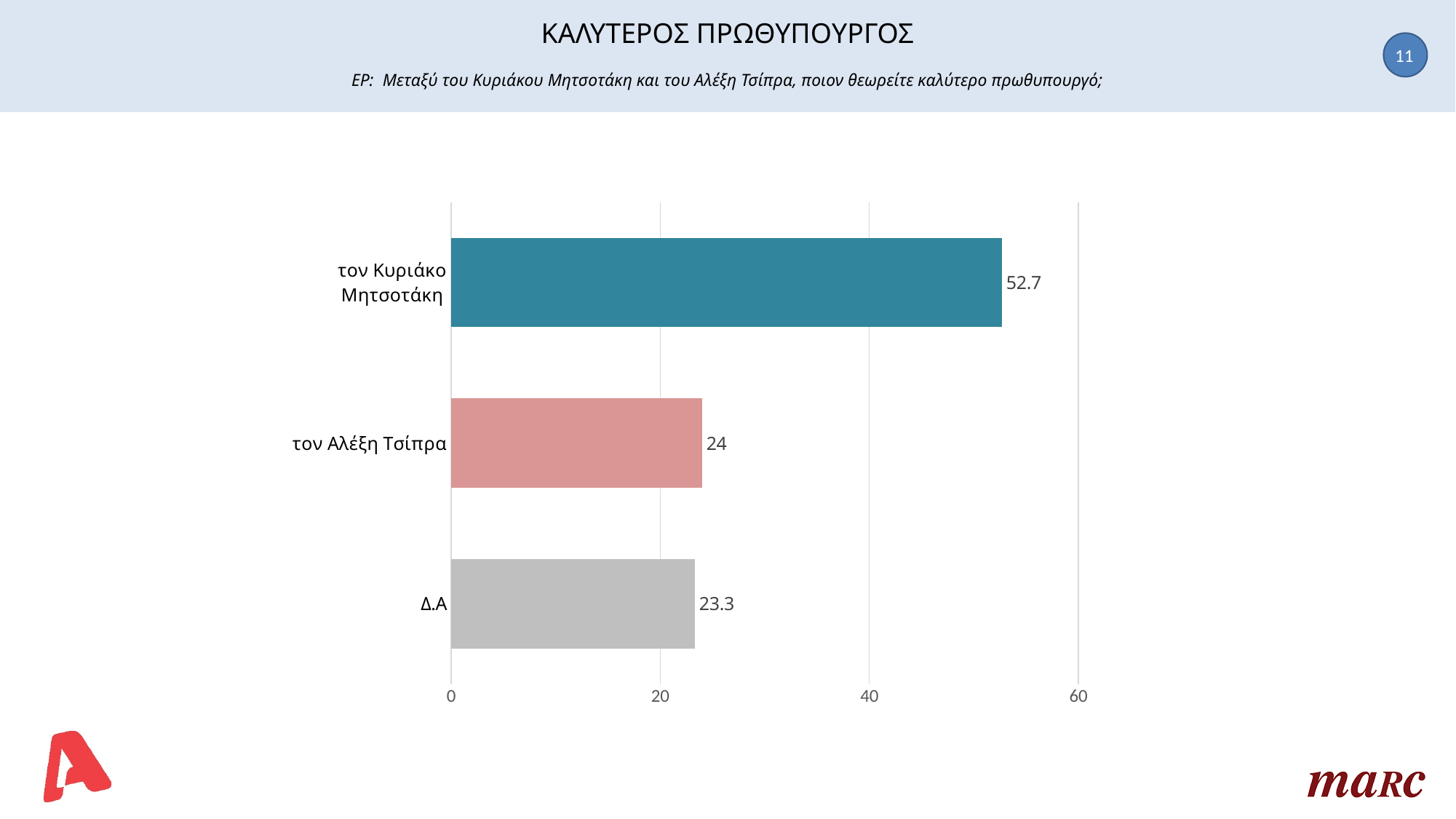
What is the difference between the values for τον Αλέξη Τσίπρα and Δ.Α? 0.7 Is the value for τον Κυριάκο Μητσοτάκη greater or less than 40? greater What is the value for τον Κυριάκο Μητσοτάκη? 52.7 Which category has the lowest value? Δ.Α What is the value for Δ.Α? 23.3 What is the value for τον Αλέξη Τσίπρα? 24 What is the title of the slide? ΚΑΛΥΤΕΡΟΣ ΠΡΩΘΥΠΟΥΡΓΟΣ How many categories are shown in the chart? 3 Which category has the highest value? τον Κυριάκο Μητσοτάκη What kind of chart is shown on the slide? bar chart What is the difference between the values for τον Κυριάκο Μητσοτάκη and τον Αλέξη Τσίπρα? 28.7 Which is larger, the value for τον Κυριάκο Μητσοτάκη or the value for Δ.Α? τον Κυριάκο Μητσοτάκη